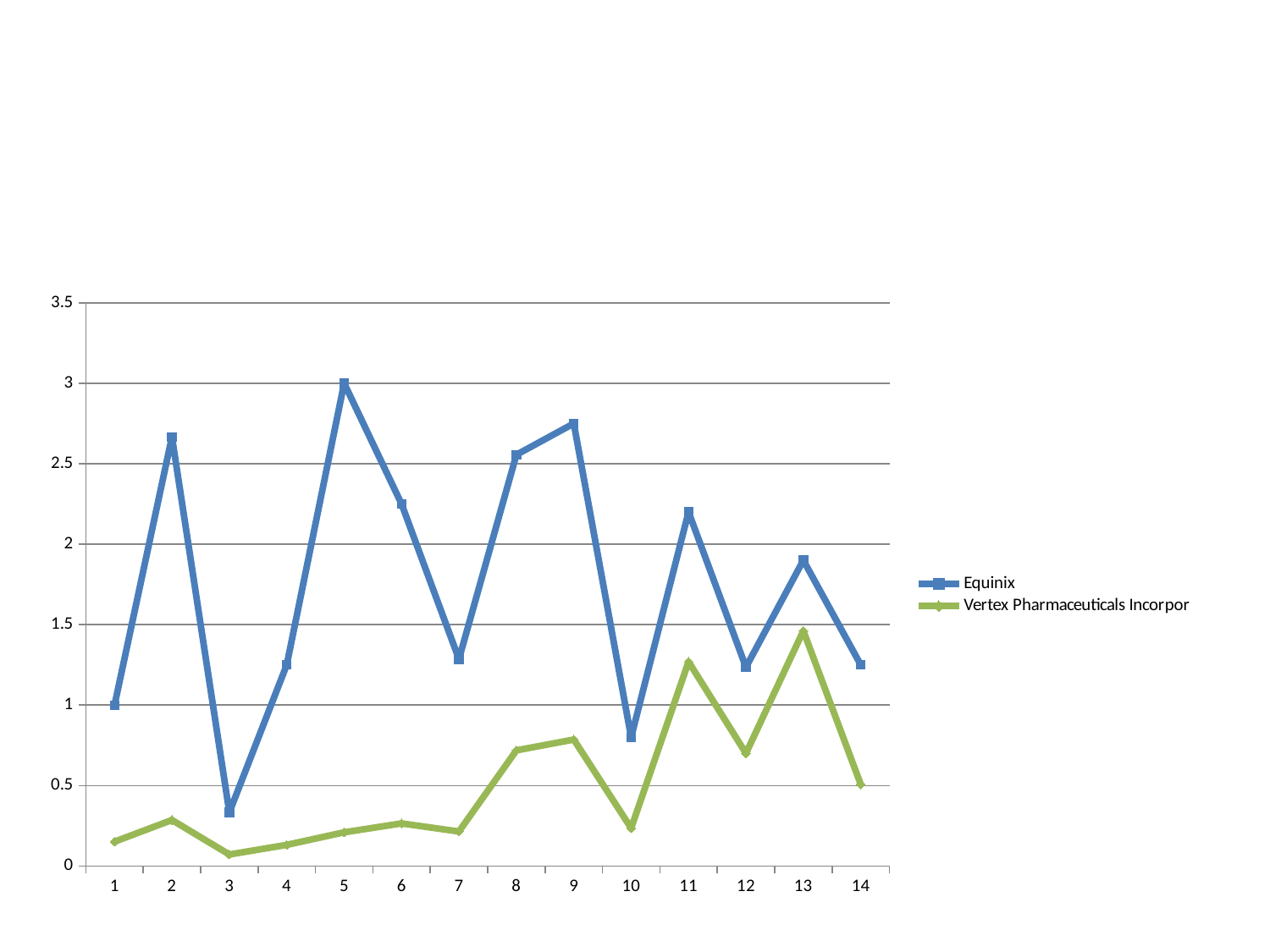
Is the Vertex Pharmaceuticals Incorpor value at x-axis point 8 greater or less than 1? less How many points are plotted along the x axis for each series? 14 At which x-axis point does the Vertex Pharmaceuticals Incorpor series reach its lowest value? 3 What kind of chart is shown on the slide? line chart At which x-axis point does the Equinix series reach its lowest value? 3 Is the Equinix value at x-axis point 10 greater or less than 1? less At x-axis point 11, which series has the larger value, Equinix or Vertex Pharmaceuticals Incorpor? Equinix Is the Equinix value at x-axis point 9 greater or less than 2.5? greater At which x-axis point does the Equinix series reach its highest value? 5 What colour is the line for the Equinix series? blue How many series does the legend list? 2 At which x-axis point does the Vertex Pharmaceuticals Incorpor series reach its highest value? 13